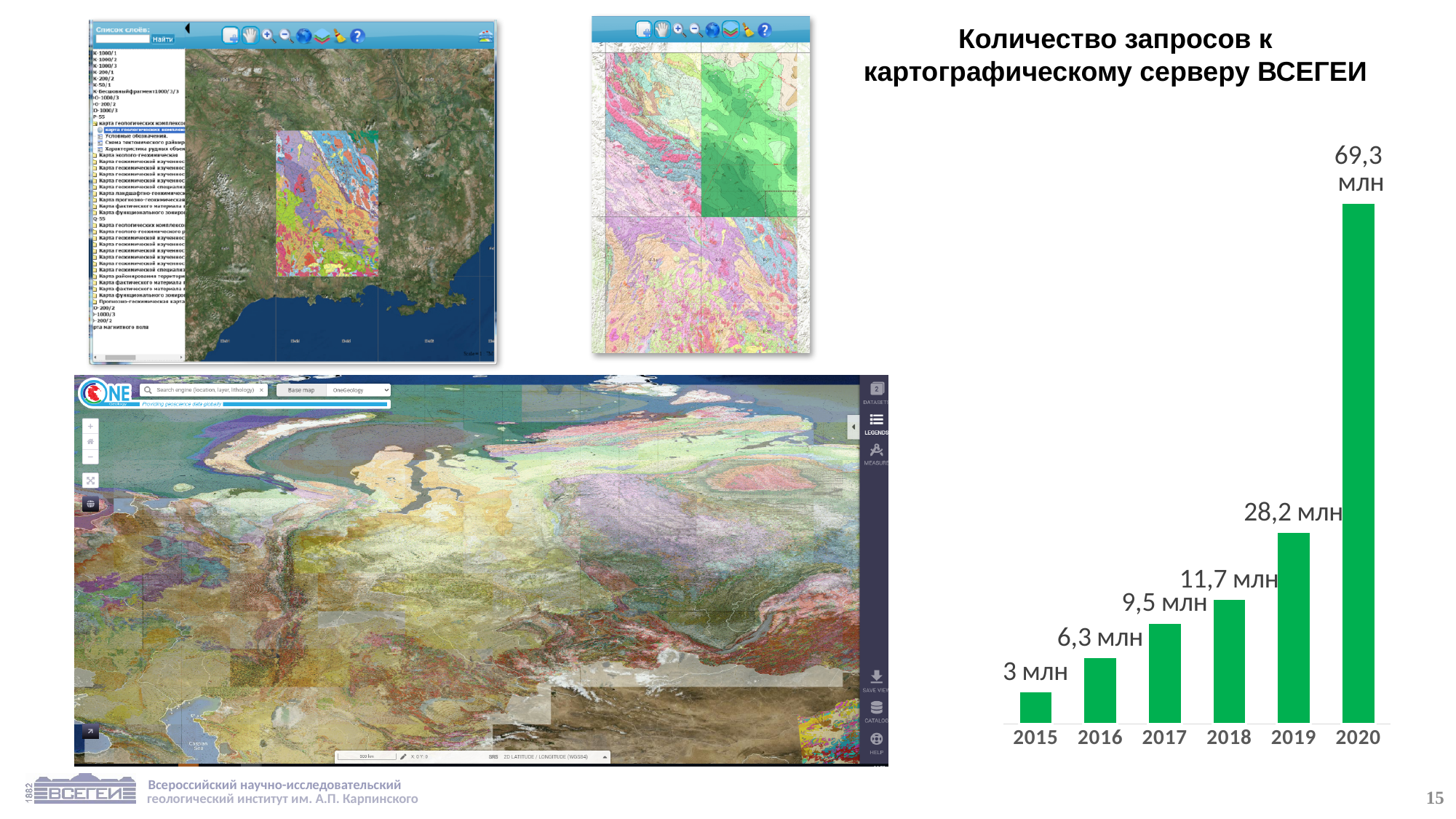
Which year has the highest value in the chart? 2020 What is the value for 2015 in the chart? 3 млн Which year has the lowest value in the chart? 2015 What kind of chart is shown on the slide? Bar chart What is the difference between the values for 2020 and 2019? 41,1 млн What is the difference between the values for 2016 and 2015? 3,3 млн What is the value for 2017 in the chart? 9,5 млн Do the values rise or fall from 2015 to 2020? Rise What is the value for 2018 in the chart? 11,7 млн What is the value for 2020 in the chart? 69,3 млн Which is larger, the value for 2019 or the value for 2018? 2019 How many years are shown on the x axis of the chart? 6